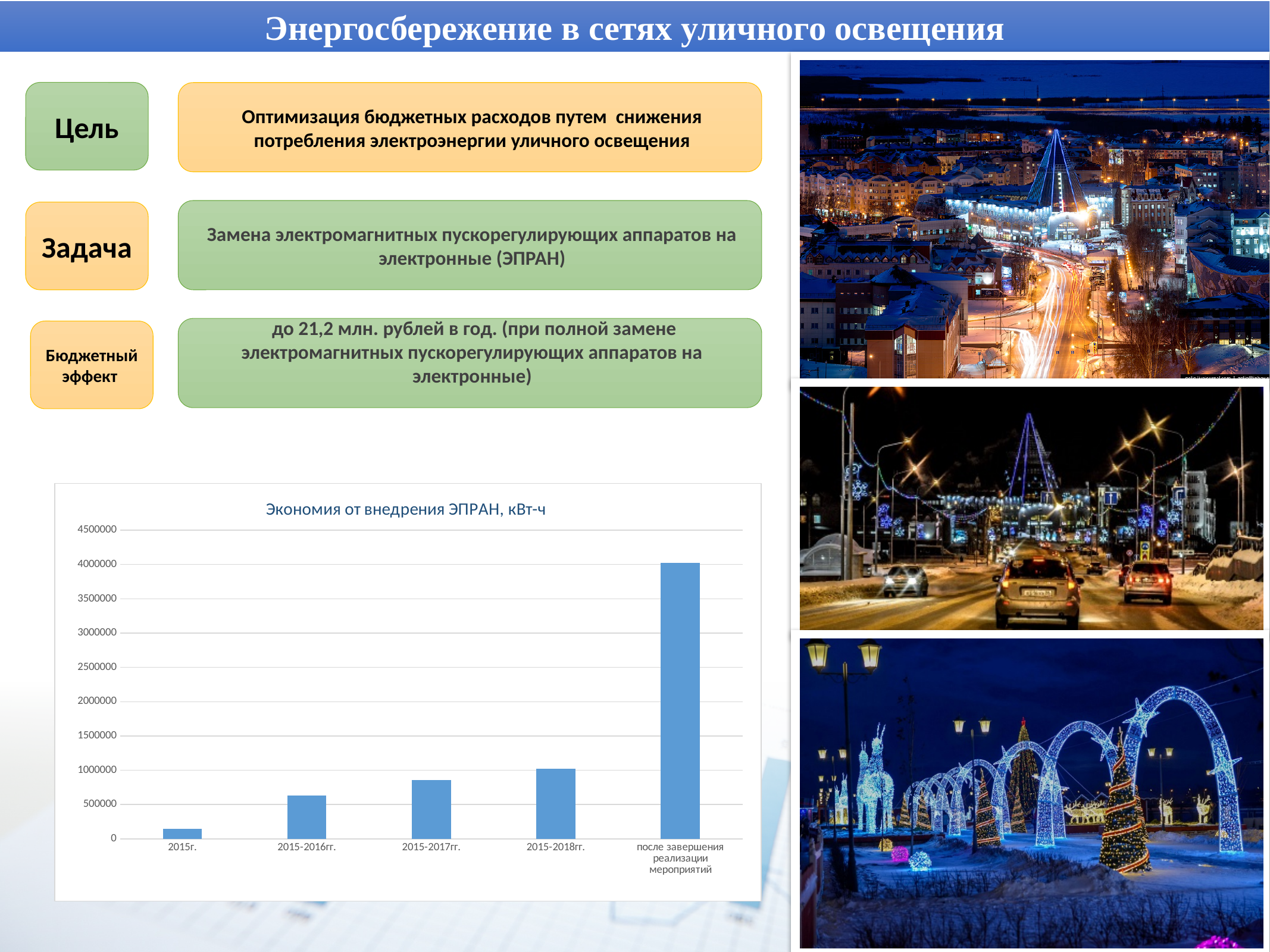
What colour are the bars in the chart? blue Is the value for 2015-2017гг. greater or less than 1000000? less Is the value for после завершения реализации мероприятий greater or less than 3500000? greater Which category has the highest value in the chart? после завершения реализации мероприятий How many categories are shown on the x axis of the chart? 5 Is the value for 2015г. greater or less than 500000? less Do the values rise or fall from left to right along the x axis? rise What kind of chart is shown on the slide? bar chart What is the title of the chart? Экономия от внедрения ЭПРАН, кВт-ч Which is larger, the value for 2015-2016гг. or the value for 2015-2018гг.? 2015-2018гг. Which category has the lowest value in the chart? 2015г.